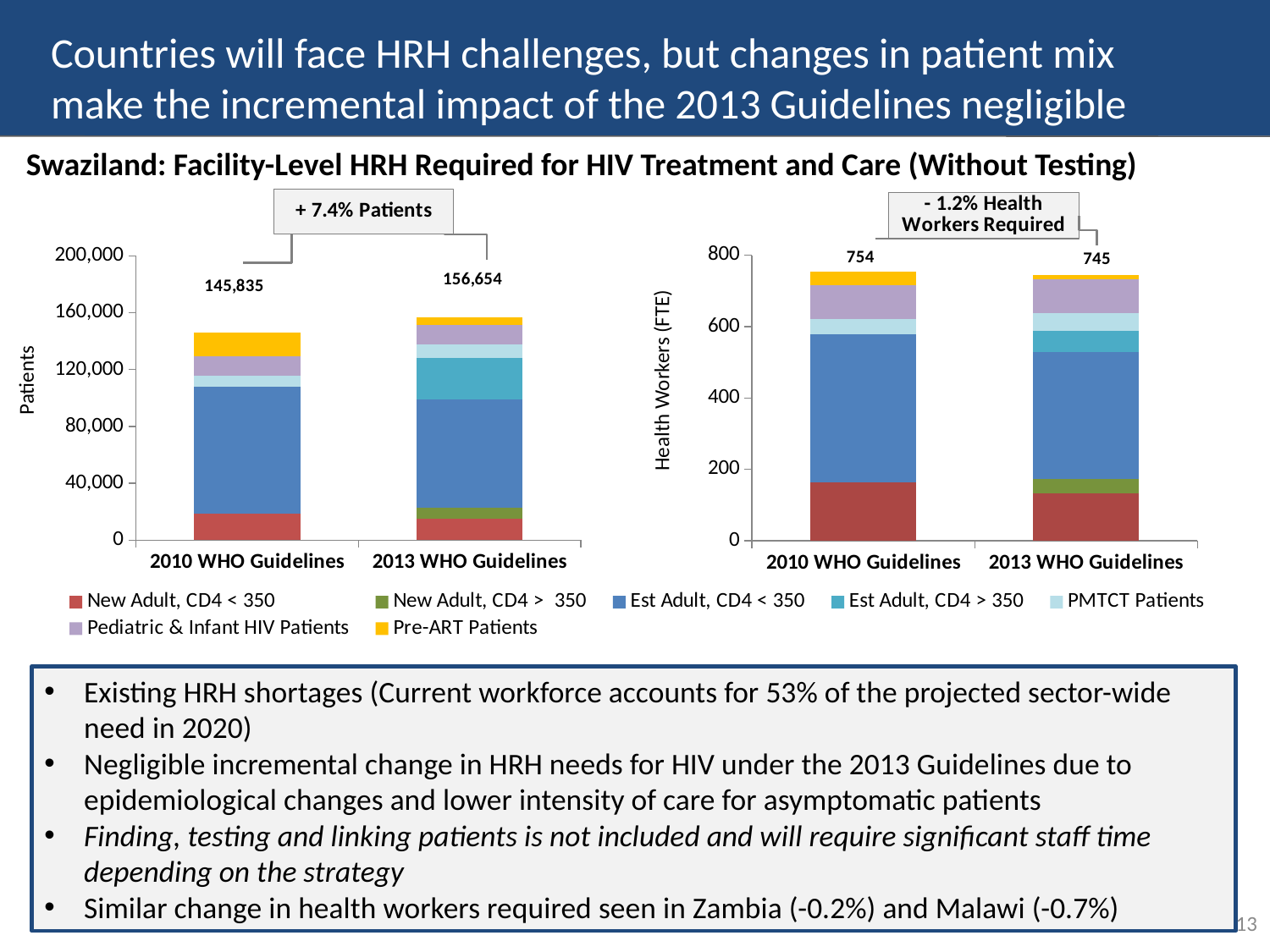
How many categories are shown on the x axis of the left chart (Patients)? 2 On the left chart (Patients), what is the total number of patients under the 2010 WHO Guidelines? 145,835 On the right chart (Health Workers), what is the total number of health workers required under the 2013 WHO Guidelines? 745 On the left chart (Patients), what is the difference in total patients between the 2013 and 2010 WHO Guidelines? 10,819 What kind of chart is the right chart (Health Workers)? Stacked bar chart On the right chart (Health Workers), what is the difference in total health workers between the 2010 and 2013 WHO Guidelines? 9 According to the callout on the left chart, by what percentage do patients increase under the 2013 WHO Guidelines? + 7.4% How many series does the shared legend list? 7 On the right chart (Health Workers), which guideline scenario requires fewer health workers? 2013 WHO Guidelines On the right chart (Health Workers), what is the total number of health workers required under the 2010 WHO Guidelines? 754 On the left chart (Patients), which guideline scenario has the larger total number of patients? 2013 WHO Guidelines